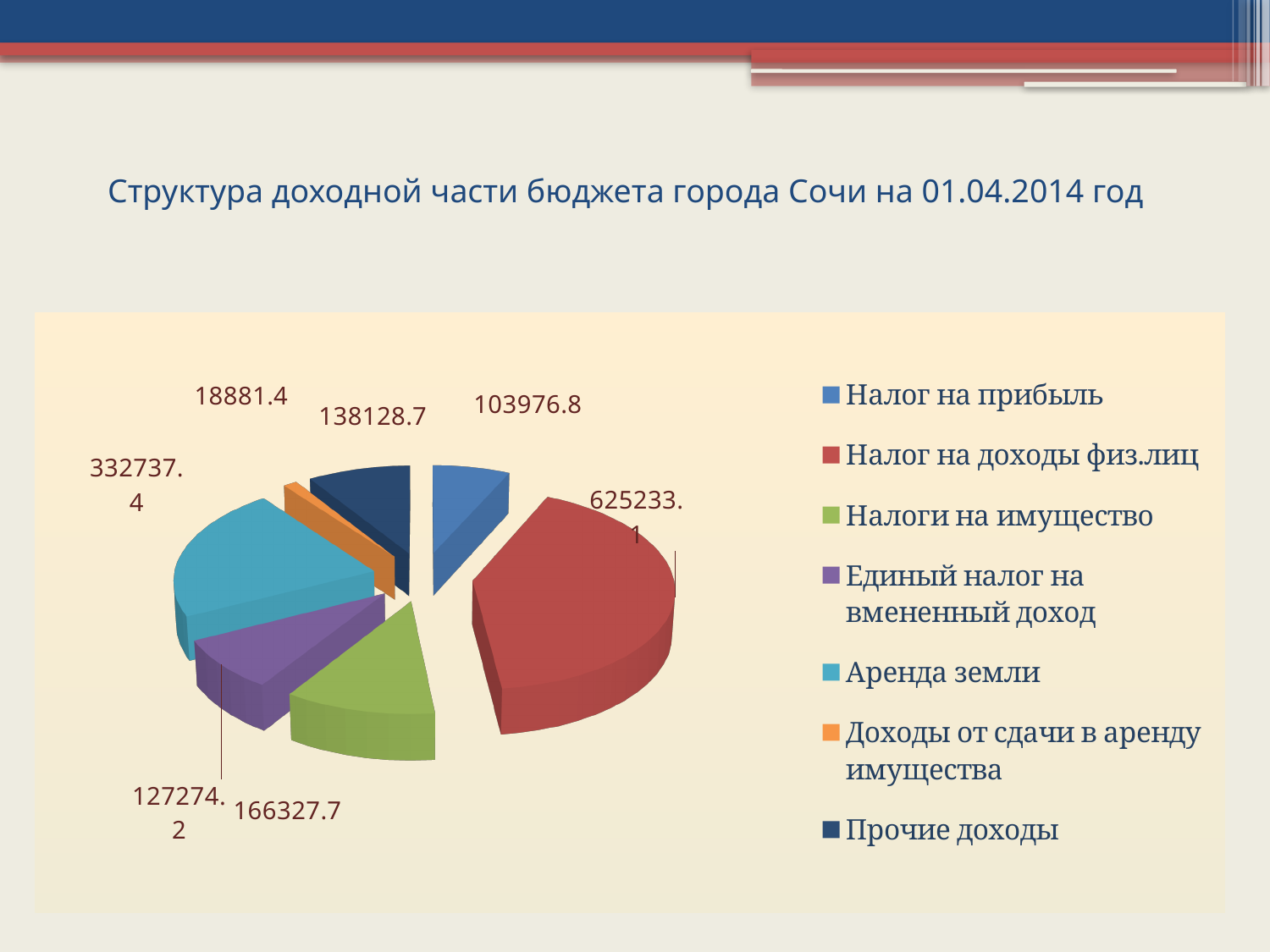
What is the value for Прочие доходы? 138128.7 Which is larger, Прочие доходы or Налог на прибыль? Прочие доходы What is the value for Доходы от сдачи в аренду имущества? 18881.4 Which category has the largest slice of the pie? Налог на доходы физ.лиц What is the difference between the values for Налог на доходы физ.лиц and Аренда земли? 292495.7 What colour is the slice for Аренда земли? Light blue (cyan) What is the difference between the values for Налоги на имущество and Единый налог на вмененный доход? 39053.5 Which category has the smallest slice of the pie? Доходы от сдачи в аренду имущества What is the value for Налог на доходы физ.лиц? 625233.1 What kind of chart is shown on the slide? Pie chart What is the value for Аренда земли? 332737.4 How many categories does the pie chart show? 7